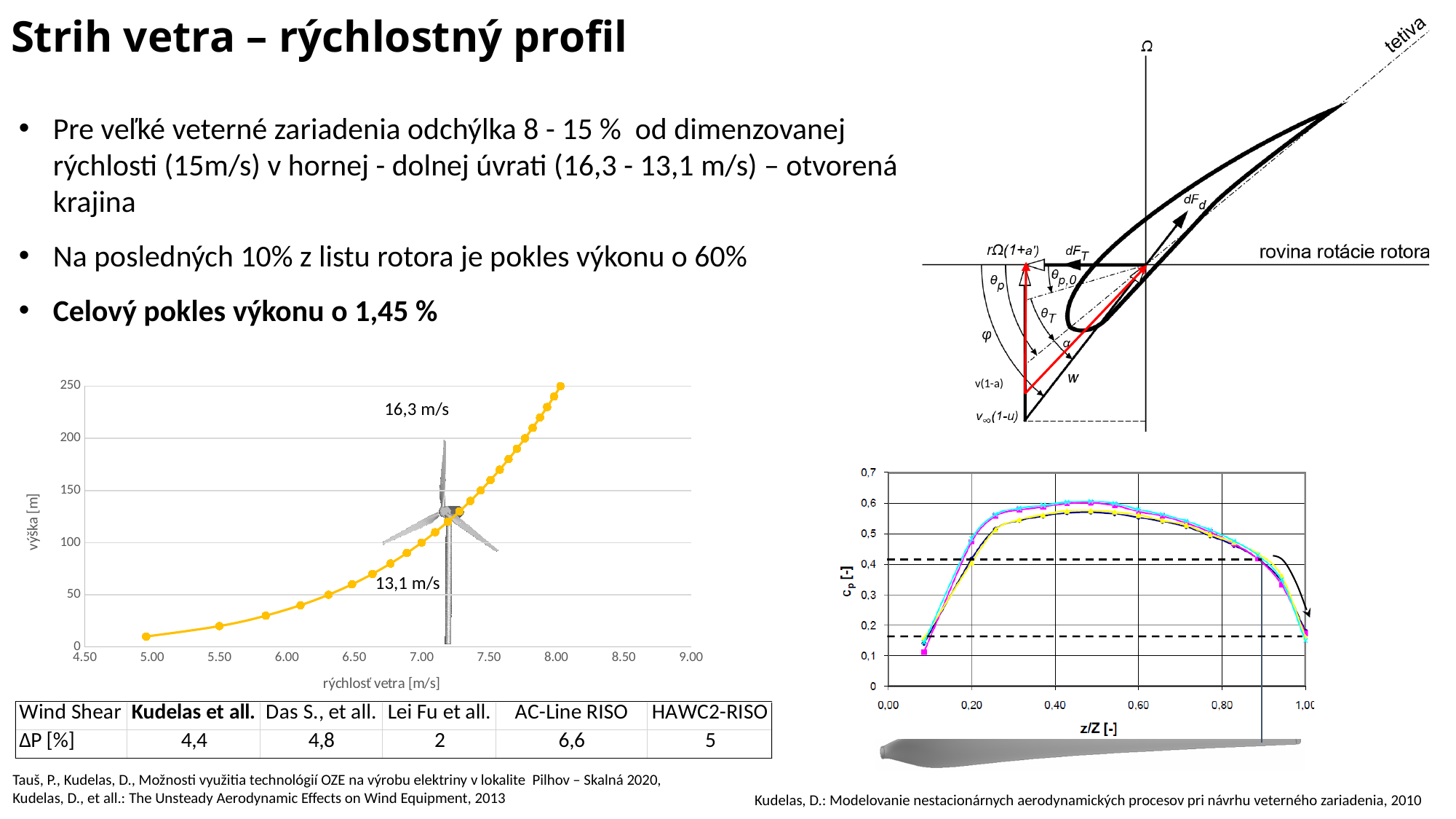
On the right chart (cp vs z/Z), is the value of cp at z/Z = 0,10 greater or less than 0,3? less On the left chart (height vs wind speed), is the height at a wind speed of 5.00 m/s greater or less than 50 m? less On the left chart (height vs wind speed), what is the highest value shown on the y axis? 250 On the left chart (height vs wind speed), what is the title of the y axis? výška [m] On the left chart (height vs wind speed), what is the title of the x axis? rýchlosť vetra [m/s] On the right chart (cp vs z/Z), is the value of cp at z/Z = 0,40 greater or less than 0,5? greater On the left chart (height vs wind speed), does the height rise or fall as wind speed increases along the x axis? rise On the left chart (height vs wind speed), which wind speed label is placed near the top of the curve, 16,3 m/s or 13,1 m/s? 16,3 m/s On the left chart (height vs wind speed), what kind of chart is it? line chart